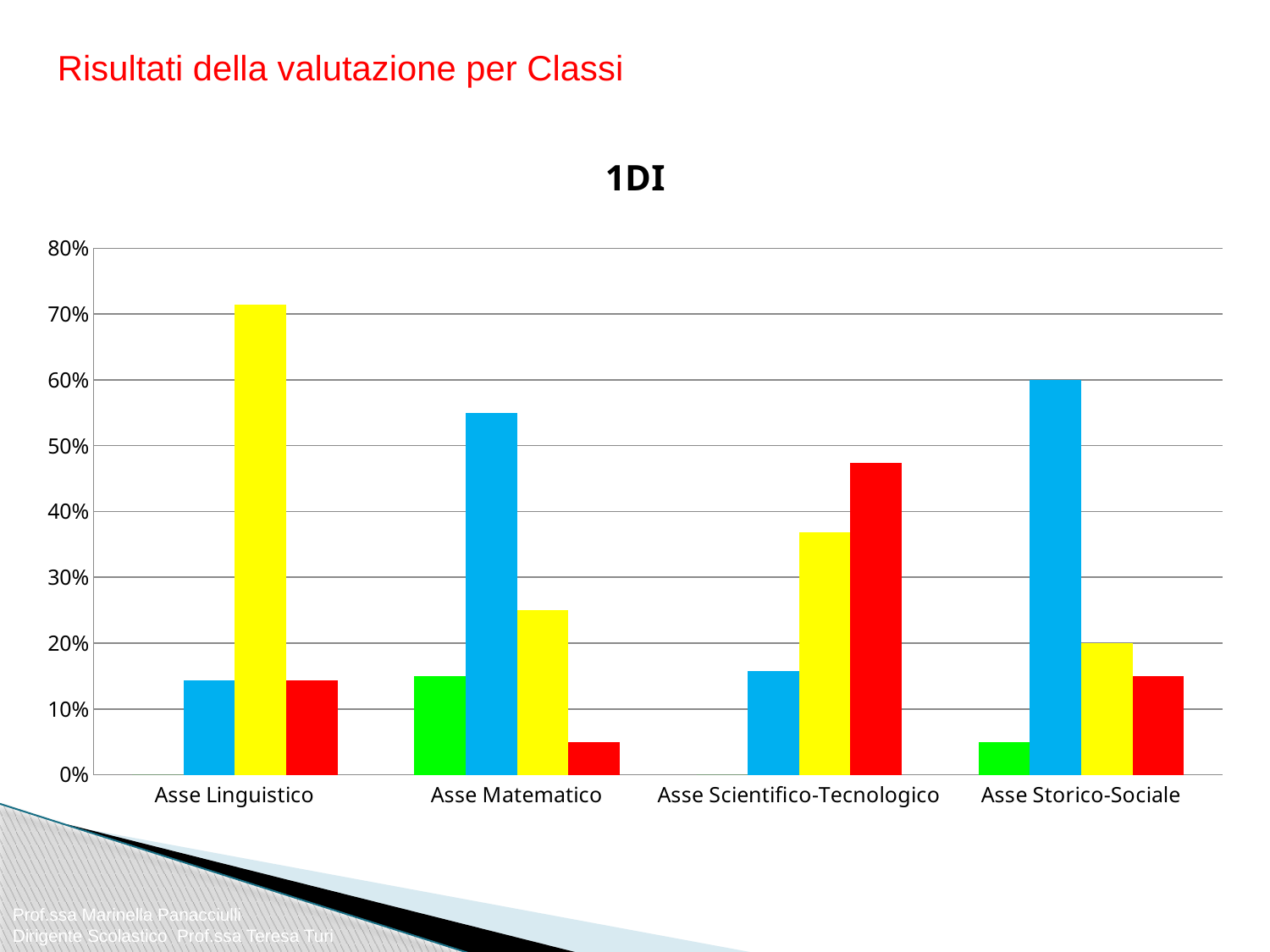
Which category has the tallest yellow bar? Asse Linguistico What kind of chart is shown on the slide? bar chart What is the title of the chart? 1DI Is the value of the blue bar for Asse Matematico greater or less than 50%? greater Is the value of the red bar for Asse Matematico greater or less than 10%? less Which category has the tallest blue bar? Asse Storico-Sociale Is the value of the yellow bar for Asse Linguistico greater or less than 60%? greater For Asse Scientifico-Tecnologico, which bar is taller, the red bar or the yellow bar? the red bar What is the title text at the top of the slide? Risultati della valutazione per Classi How many categories are shown on the x axis of the chart? 4